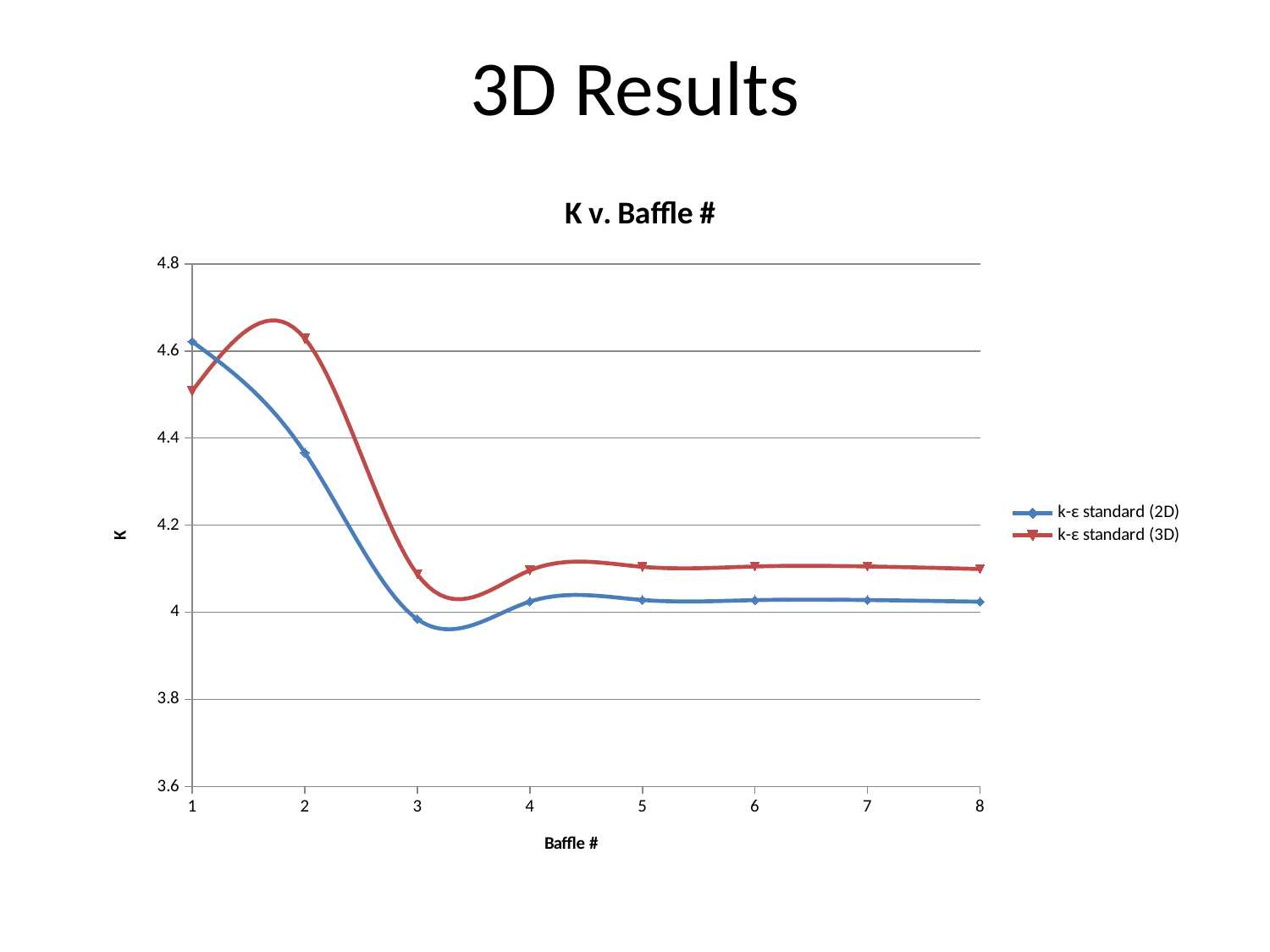
What kind of chart is shown on the slide? line chart At which baffle number does the k-ε standard (2D) series reach its lowest value? 3 How many series does the legend list? 2 Does the k-ε standard (2D) series rise or fall from baffle 1 to baffle 3? fall Is the k-ε standard (2D) value at baffle 2 greater or less than 4.4? less What is the title of the chart? K v. Baffle # How many baffle numbers are plotted along the x axis? 8 At baffle 5, which series has the larger K value, k-ε standard (2D) or k-ε standard (3D)? k-ε standard (3D) At which baffle number does the k-ε standard (2D) series reach its highest value? 1 At baffle 1, which series has the larger K value, k-ε standard (2D) or k-ε standard (3D)? k-ε standard (2D) What is the label of the x axis? Baffle # At which baffle number does the k-ε standard (3D) series reach its highest value? 2